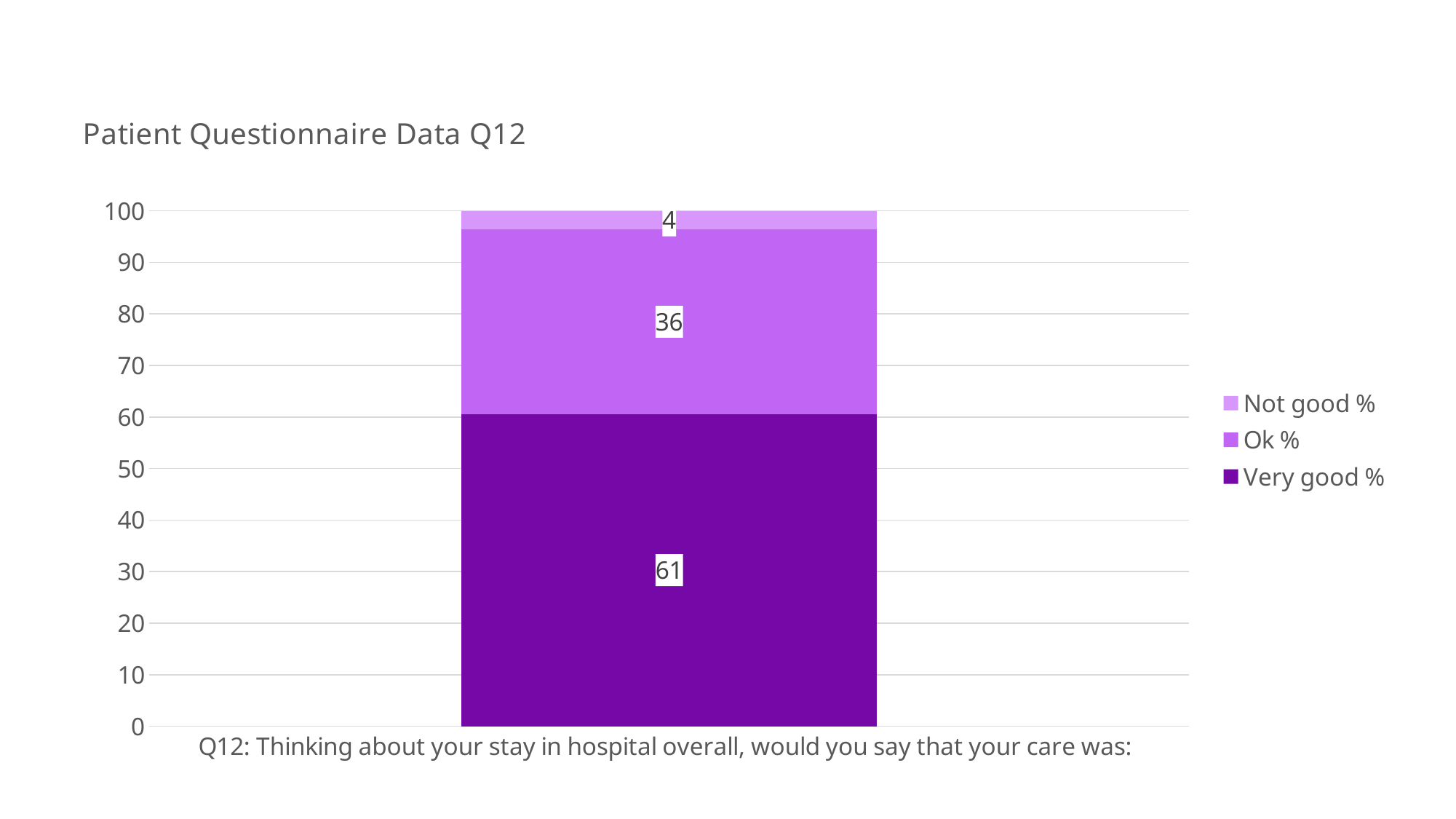
How many series does the legend list? 3 What kind of chart is shown on the slide? Stacked bar chart What is the difference between the Very good % value and the Ok % value? 25 What is the title of the chart? Patient Questionnaire Data Q12 What is the total of the stacked bar? 101 Is the value for Very good % greater or less than 50? greater Which series has the largest value in the bar? Very good % Which series has the smallest value in the bar? Not good % What is the value for Not good % in the stacked bar? 4 Which is larger, the Ok % value or the Not good % value? Ok % What is the value for Very good % in the stacked bar? 61 What is the value for Ok % in the stacked bar? 36